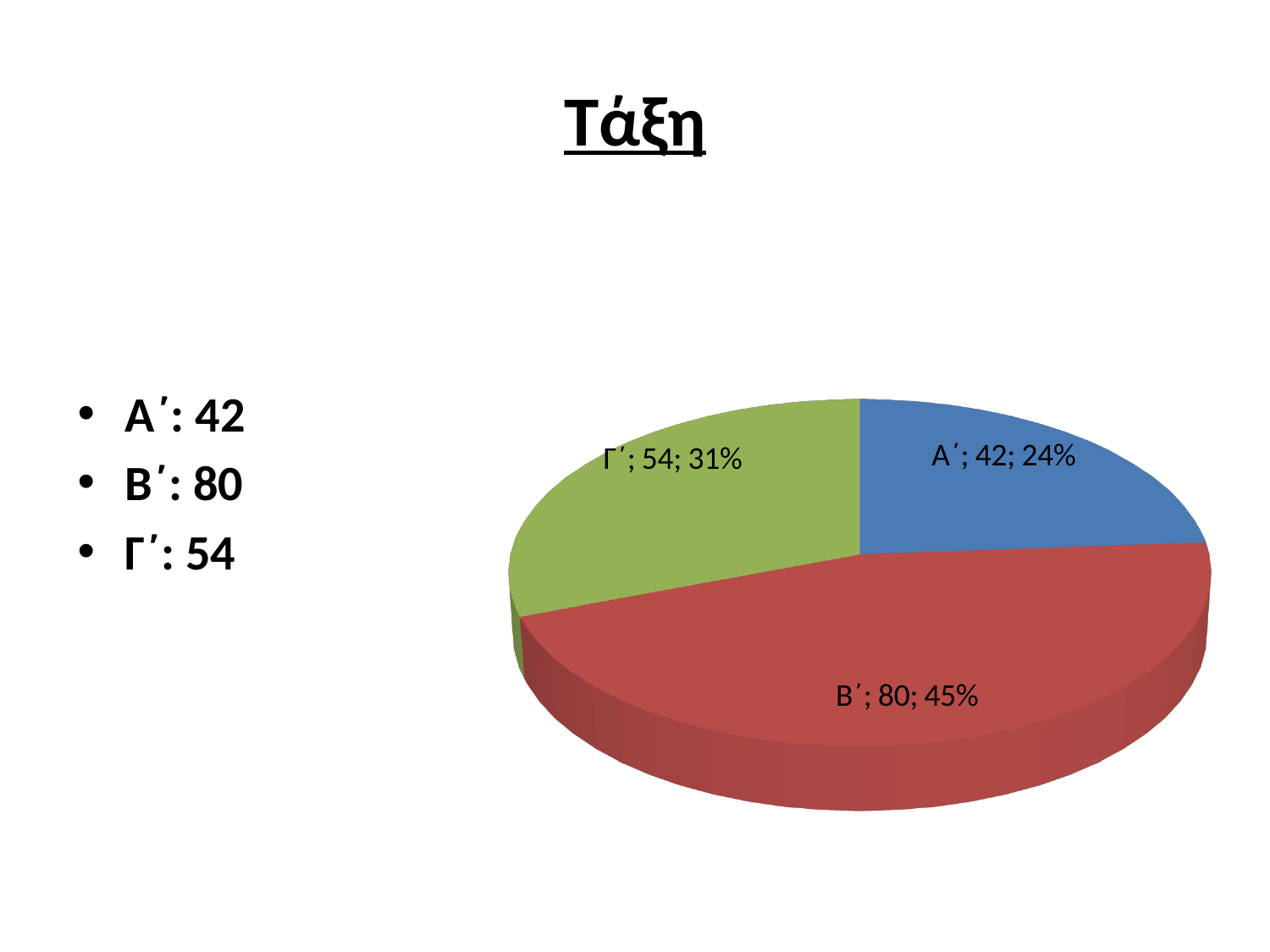
Which category has the largest slice in the pie chart? Β΄ What share of the pie does Α΄ represent? 24% What is the value for Γ΄ in the pie chart? 54 What is the value for Β΄ in the pie chart? 80 What kind of chart is shown on the slide? pie chart What share of the pie does Β΄ represent? 45% What is the value for Α΄ in the pie chart? 42 Which is larger, the value for Γ΄ or the value for Α΄? Γ΄ What is the difference between the values for Β΄ and Γ΄? 26 How many slices does the pie chart have? 3 What share of the pie does Γ΄ represent? 31% Which category has the smallest slice in the pie chart? Α΄